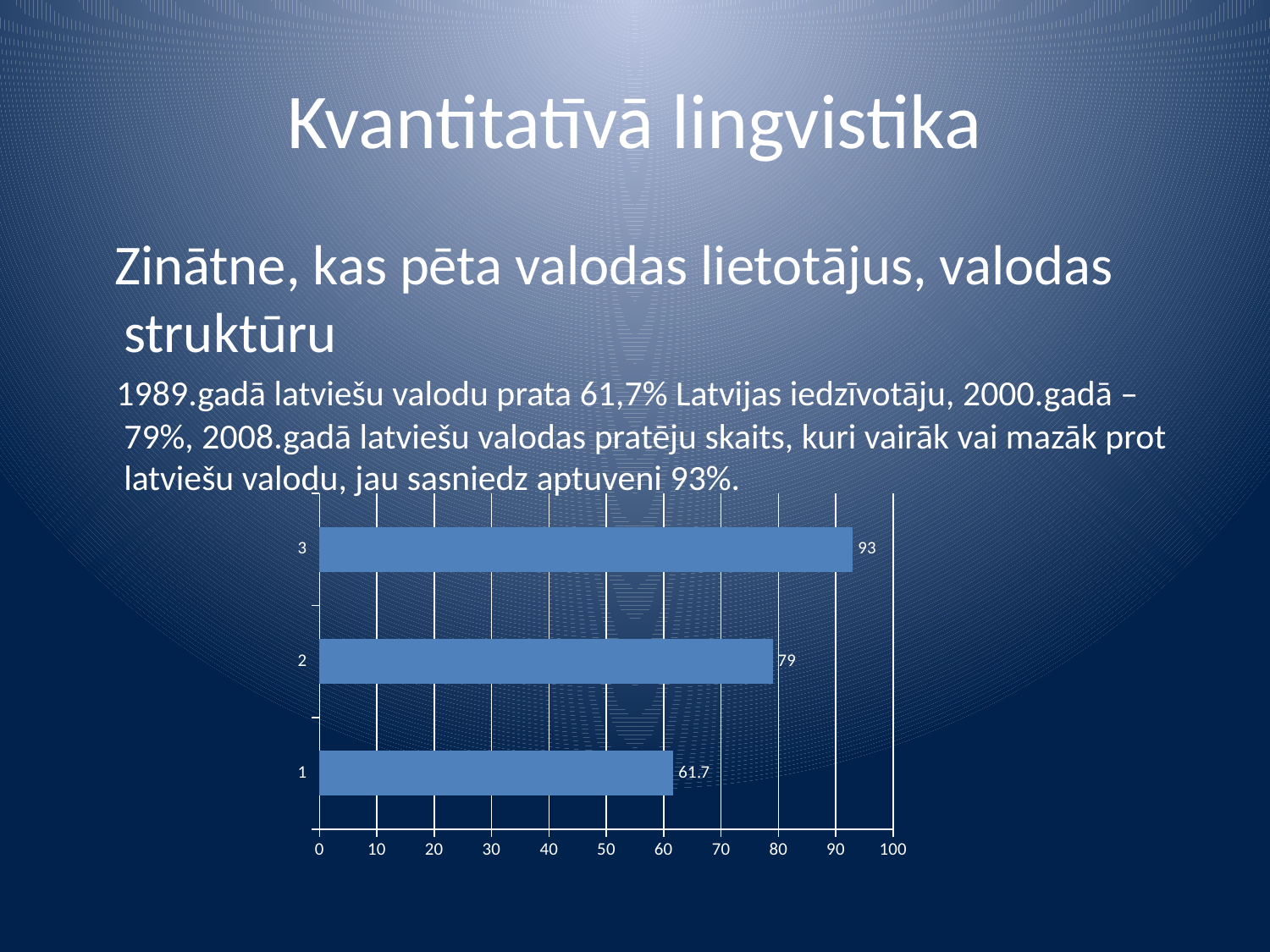
Which is larger, the value for category 1 or the value for category 2? category 2 What is the value for category 3? 93 Which category has the lowest value? 1 Which category has the highest value? 3 What type of chart is shown on the slide? bar chart Is the value for category 3 greater or less than 90? greater What is the difference between the values for category 3 and category 2? 14 What is the value for category 1? 61.7 How many bars are plotted in the chart? 3 What is the value for category 2? 79 What is the difference between the values for category 2 and category 1? 17.3 What is the maximum value shown on the horizontal axis? 100